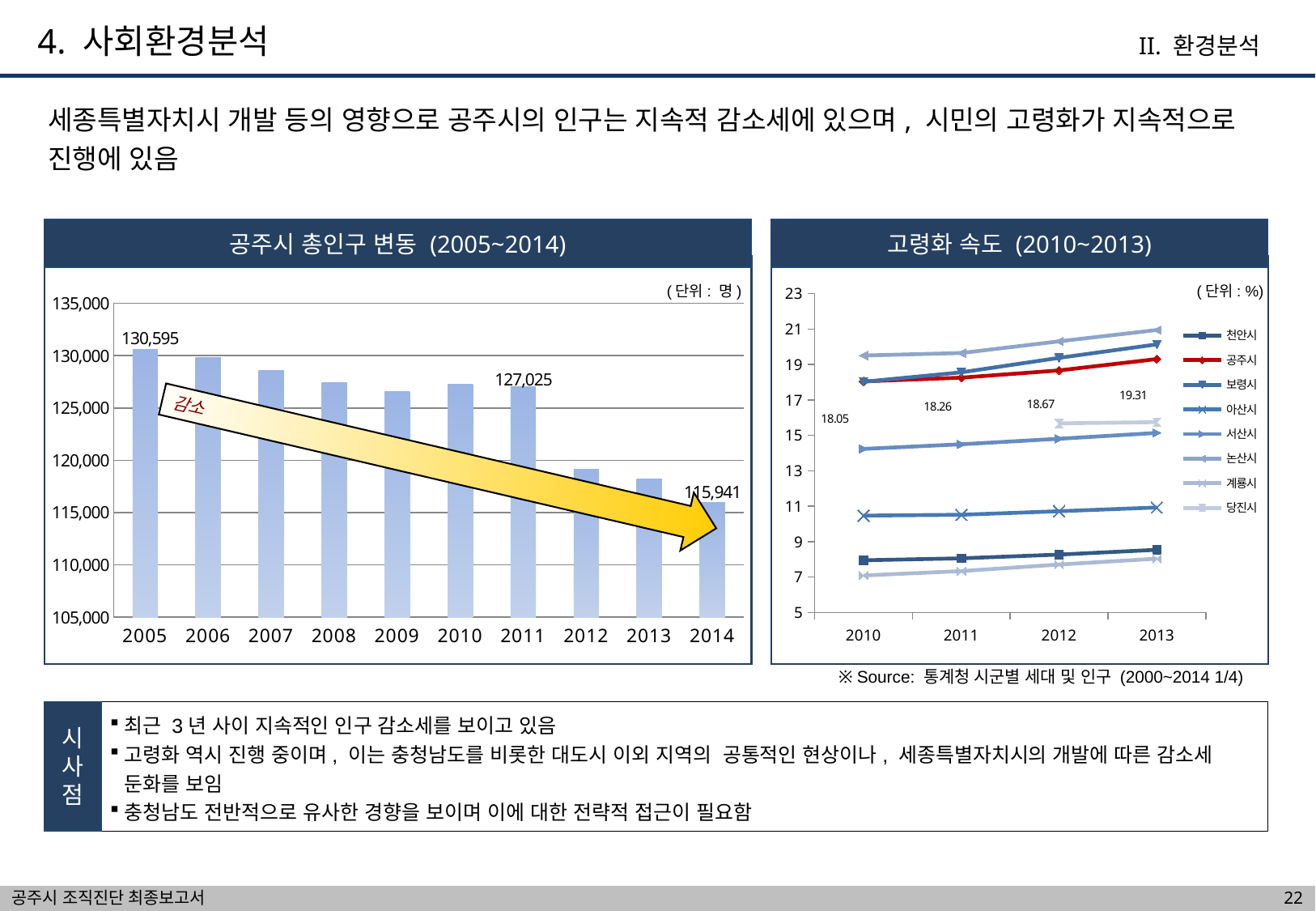
In the '공주시 총인구 변동 (2005~2014)' chart, what is the population value for 2011? 127,025 In the '공주시 총인구 변동 (2005~2014)' chart, what is the population value for 2014? 115,941 In the '공주시 총인구 변동 (2005~2014)' chart, what is the difference between the 2005 and 2014 values? 14,654 In the '공주시 총인구 변동 (2005~2014)' chart, is the value for 2012 greater or less than 120,000? less In the '고령화 속도 (2010~2013)' chart, what is the difference between the 공주시 values for 2013 and 2010? 1.26 In the '고령화 속도 (2010~2013)' chart, what is the value for 공주시 in 2013? 19.31 How many years are shown on the x axis of the '공주시 총인구 변동 (2005~2014)' chart? 10 In the '공주시 총인구 변동 (2005~2014)' chart, what is the population value for 2005? 130,595 In the '공주시 총인구 변동 (2005~2014)' chart, do the values generally rise or fall from 2005 to 2014? fall In the '고령화 속도 (2010~2013)' chart, is the value for 아산시 in 2010 greater or less than 9? greater What kind of chart is the '공주시 총인구 변동 (2005~2014)' chart on the left? bar chart How many series does the legend of the '고령화 속도 (2010~2013)' chart list? 8